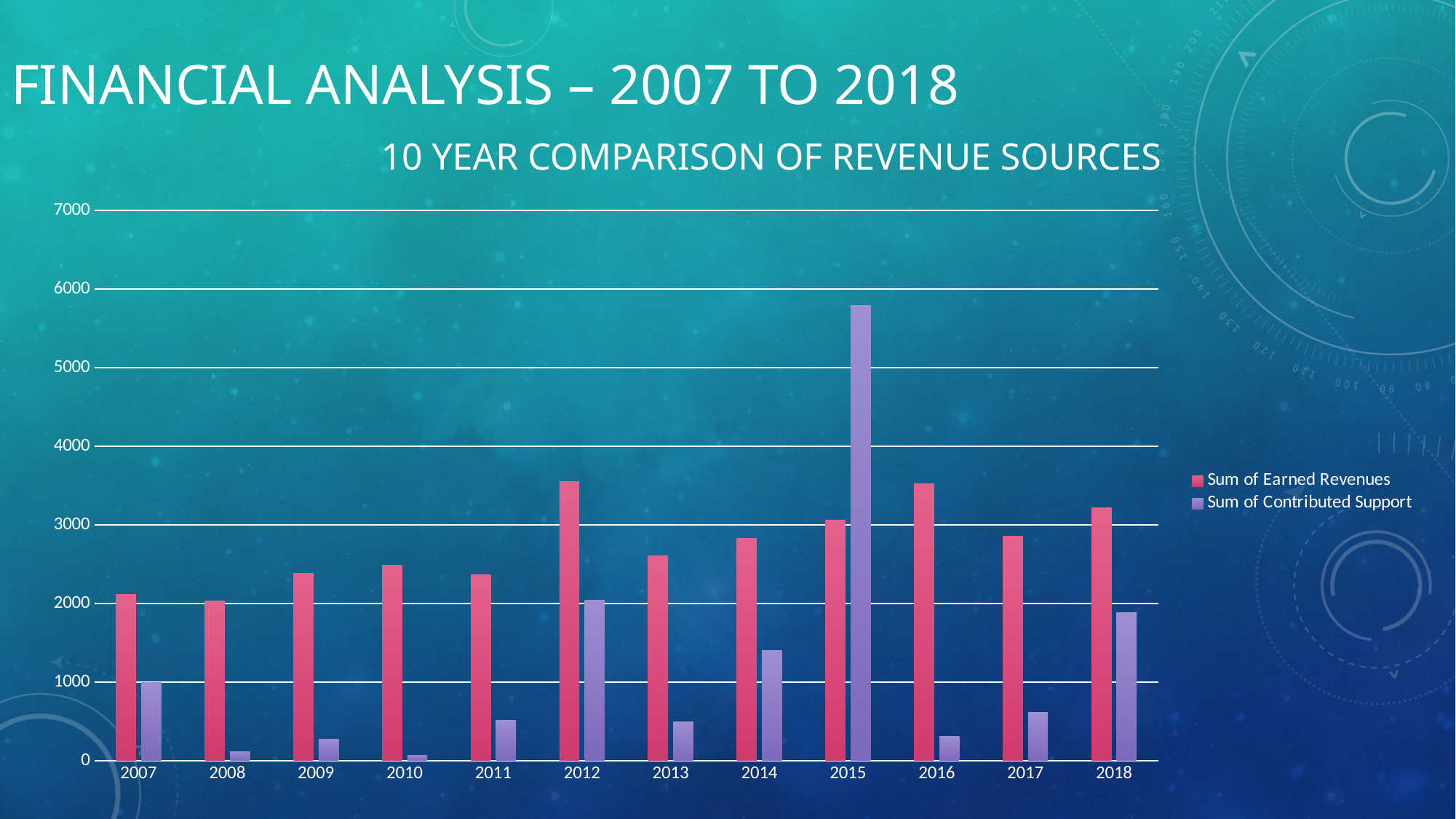
In 2012, which is larger: Sum of Earned Revenues or Sum of Contributed Support? Sum of Earned Revenues How many years are shown along the x axis of the chart? 12 Is the Sum of Contributed Support for 2008 greater or less than 500? less Is the Sum of Contributed Support for 2015 greater or less than 5000? greater What kind of chart is shown on the slide? Bar chart Which year has the lowest Sum of Contributed Support? 2010 How many series does the chart legend list? 2 Is the Sum of Earned Revenues for 2010 greater or less than 3000? less What is the title of the chart? 10 YEAR COMPARISON OF REVENUE SOURCES Which year has the highest Sum of Contributed Support? 2015 In 2015, which is larger: Sum of Earned Revenues or Sum of Contributed Support? Sum of Contributed Support